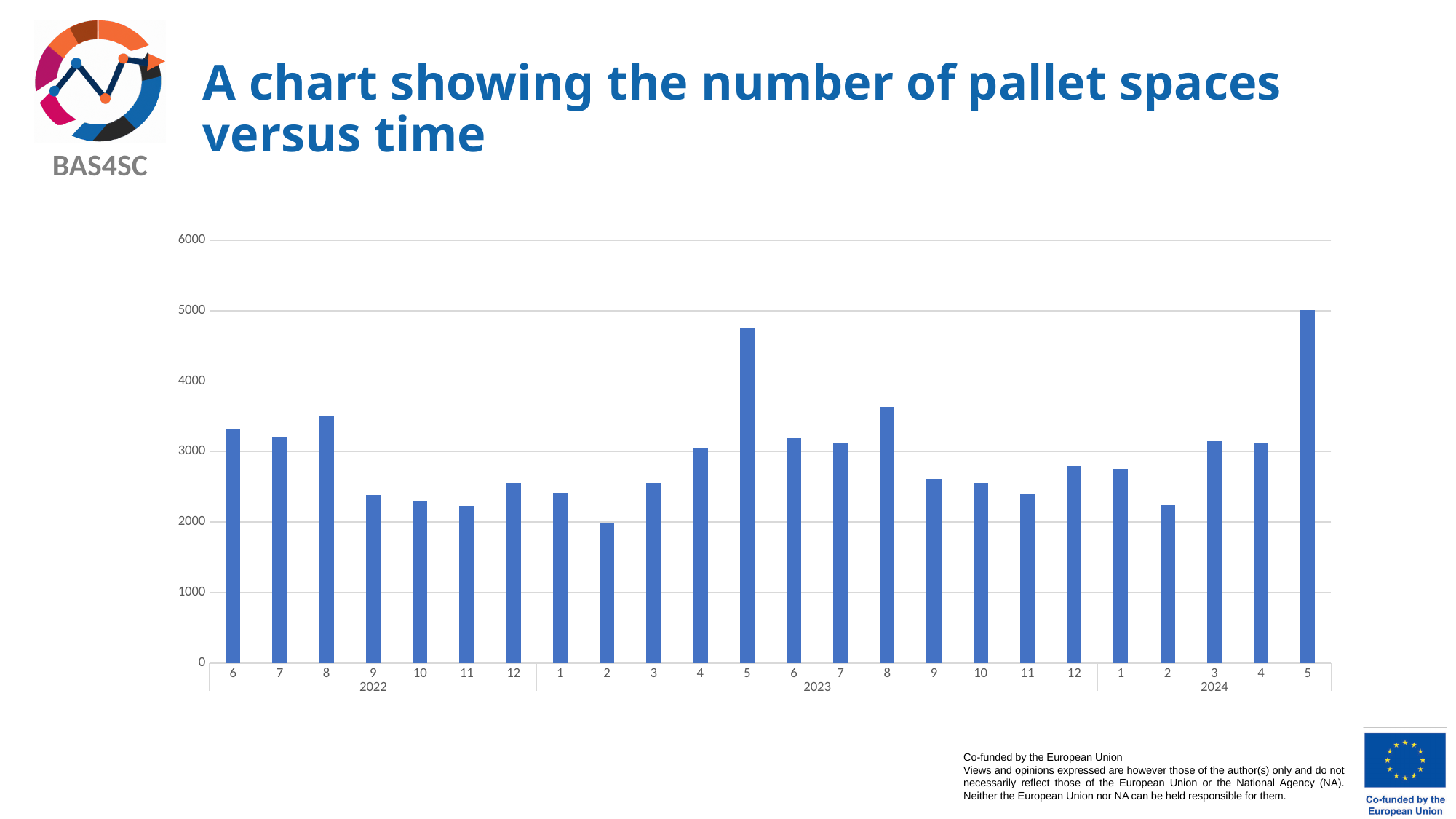
Is the value for month 8 of 2023 greater or less than 3000? greater What is the title of the slide containing the chart? A chart showing the number of pallet spaces versus time Which month has the lowest number of pallet spaces? 2 (February) 2023 Which is larger, the value for month 5 of 2023 or month 8 of 2023? month 5 of 2023 Which is larger, the value for month 2 of 2023 or month 3 of 2023? month 3 of 2023 Which month has the highest number of pallet spaces? 5 (May) 2024 What kind of chart is shown on the slide? bar chart Is the value for month 9 of 2022 greater or less than 3000? less Do the values rise or fall from month 8 of 2022 to month 11 of 2022? fall Is the value for month 2 of 2024 greater or less than 3000? less How many bars (months) are plotted in the chart? 24